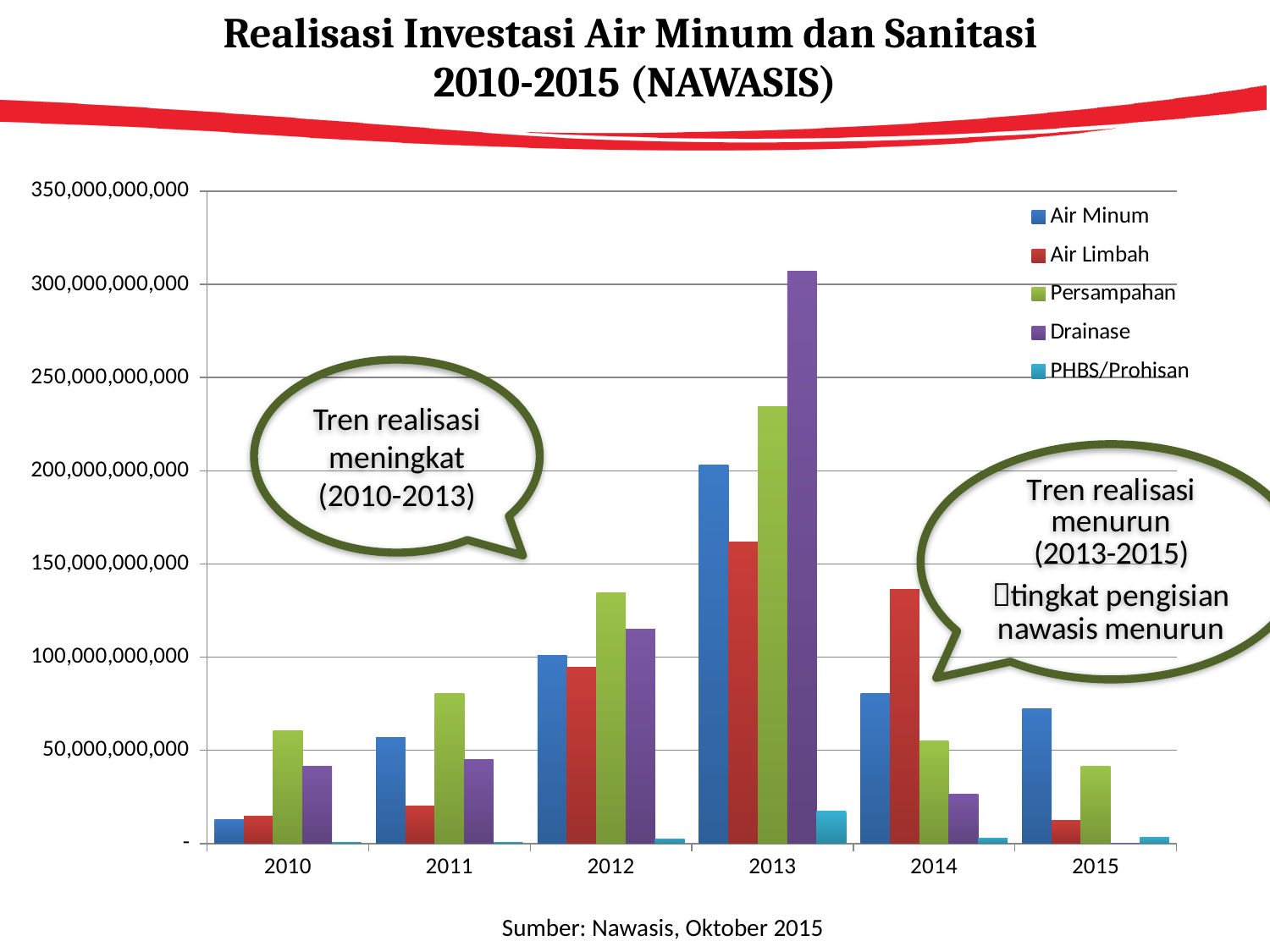
In which year is the Drainase bar the highest? 2013 How many years are shown on the x axis? 6 Which series has the highest value in 2010? Persampahan In 2012, which is larger: Persampahan or Air Minum? Persampahan What kind of chart is shown on the slide? bar chart In 2014, which is larger: Air Limbah or Air Minum? Air Limbah Do the Air Minum values rise or fall from 2010 to 2013? rise Is the value for Air Minum in 2013 greater or less than 150,000,000,000? greater How many series does the legend list? 5 Which series has the lowest value in 2013? PHBS/Prohisan Is the value for Drainase in 2013 greater or less than 300,000,000,000? greater Is the value for Persampahan in 2011 greater or less than 100,000,000,000? less